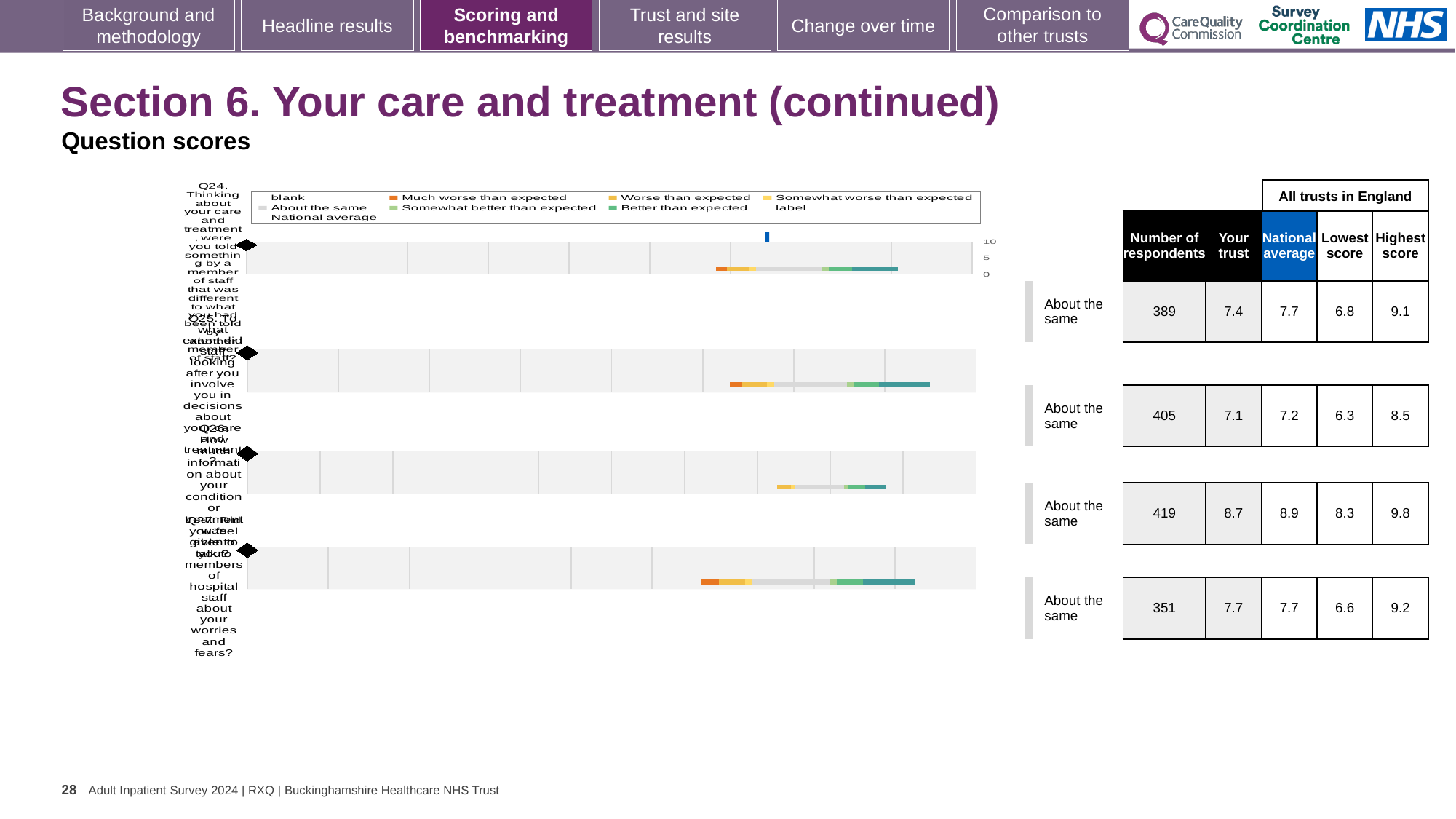
What benchmark category is shown for Q26 on this slide? About the same What is the lowest score across all trusts in England for Q25? 6.3 What is the difference between the national average and the 'Your trust' score for Q24? 0.3 Which has the higher 'Your trust' score, Q24 or Q25? Q24 What kind of chart is used to show the question scores on this slide? Bar chart What is the 'Your trust' score for Q26 (how much information about your condition or treatment was given to you)? 8.7 How many respondents are listed for Q24 (being told something different by another member of staff)? 389 Which question has the highest 'Your trust' score on this slide? Q26 Which question has the lowest number of respondents on this slide? Q27 What is the highest score across all trusts in England for Q27 (feeling able to talk to staff about worries and fears)? 9.2 How many questions are plotted on this slide? 4 What is the national average score for Q25 (staff involving you in decisions about your care and treatment)? 7.2